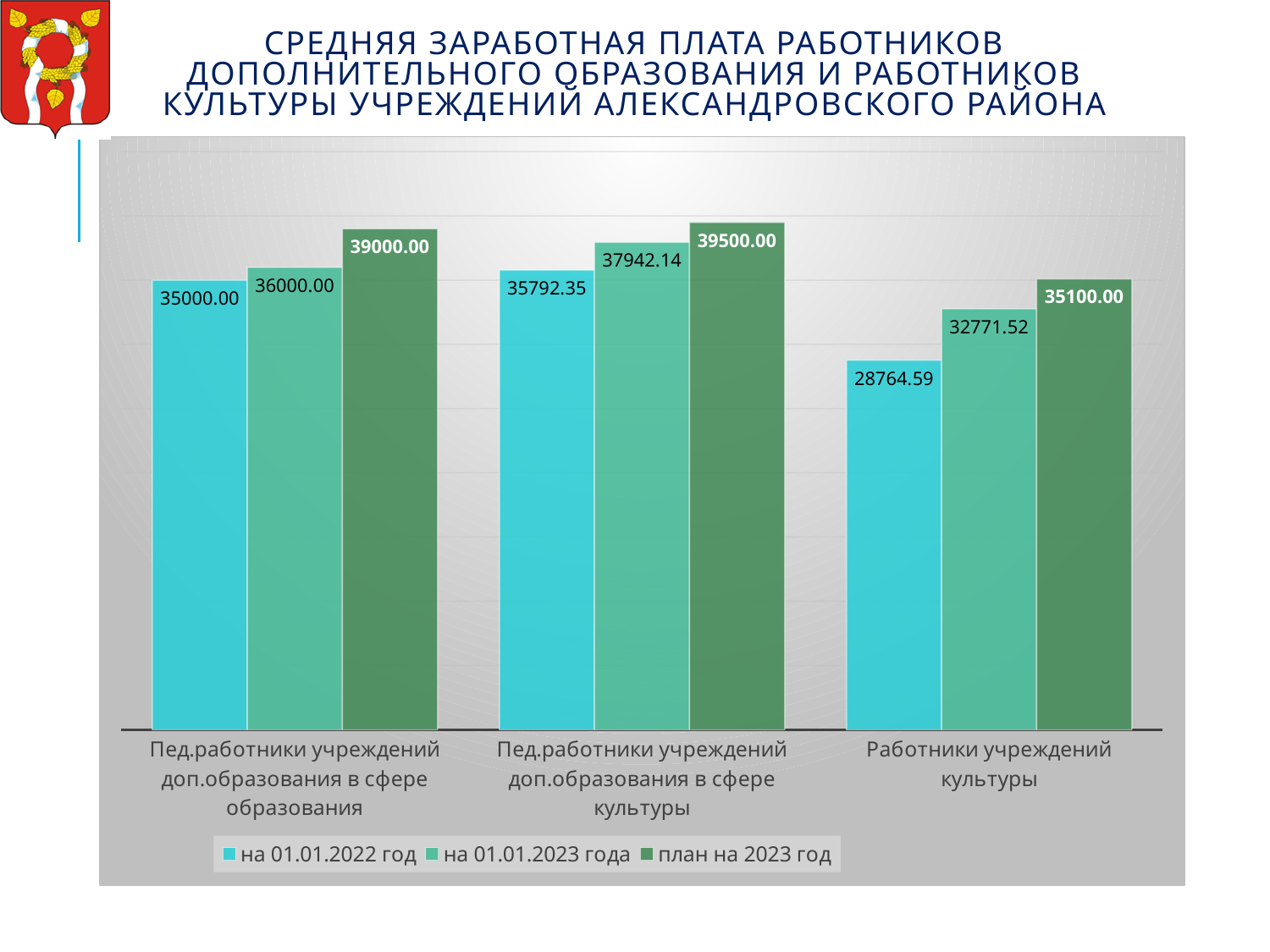
How many series does the legend list? 3 Which category has the lowest value in the series на 01.01.2022 год? Работники учреждений культуры What is the value for Пед.работники учреждений доп.образования в сфере культуры in the series на 01.01.2023 года? 37942.14 What is the difference between the план на 2023 год value and the на 01.01.2022 год value for Пед.работники учреждений доп.образования в сфере образования? 4000.00 What is the value for Работники учреждений культуры in the series на 01.01.2022 год? 28764.59 Which category has the highest план на 2023 год value? Пед.работники учреждений доп.образования в сфере культуры What is the план на 2023 год value for Работники учреждений культуры? 35100.00 What kind of chart is shown on the slide? Bar chart Which is larger: the на 01.01.2023 года value for Пед.работники учреждений доп.образования в сфере образования or for Пед.работники учреждений доп.образования в сфере культуры? Пед.работники учреждений доп.образования в сфере культуры What is the план на 2023 год value for Пед.работники учреждений доп.образования в сфере образования? 39000.00 How many categories are shown on the x axis? 3 What is the difference between the на 01.01.2023 года value and the на 01.01.2022 год value for Работники учреждений культуры? 4006.93